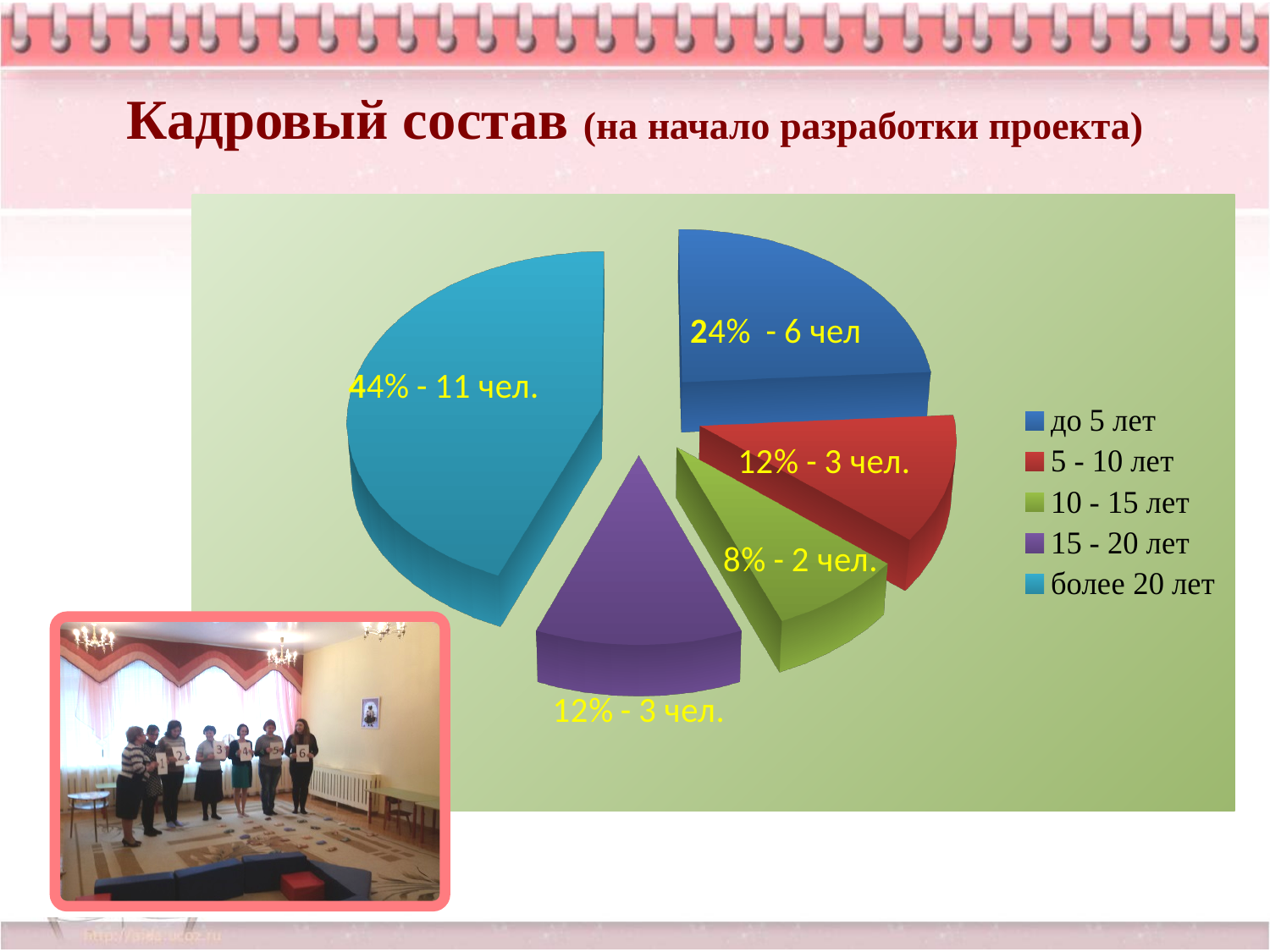
How many people are in the '5 - 10 лет' category? 3 What percentage share does the 'более 20 лет' slice have? 44% Which category has the largest share of the pie? более 20 лет What is the title of the slide containing the pie chart? Кадровый состав (на начало разработки проекта) What percentage is shown for the '10 - 15 лет' slice? 8% What is the difference in people between the 'более 20 лет' and 'до 5 лет' categories? 5 What colour is the slice for 'более 20 лет'? light blue What kind of chart is shown on the slide? pie chart Which is larger: the share for 'до 5 лет' or the share for '15 - 20 лет'? до 5 лет How many people (чел.) are in the 'до 5 лет' category? 6 How many categories does the legend of the pie chart list? 5 Which category has the smallest share of the pie? 10 - 15 лет